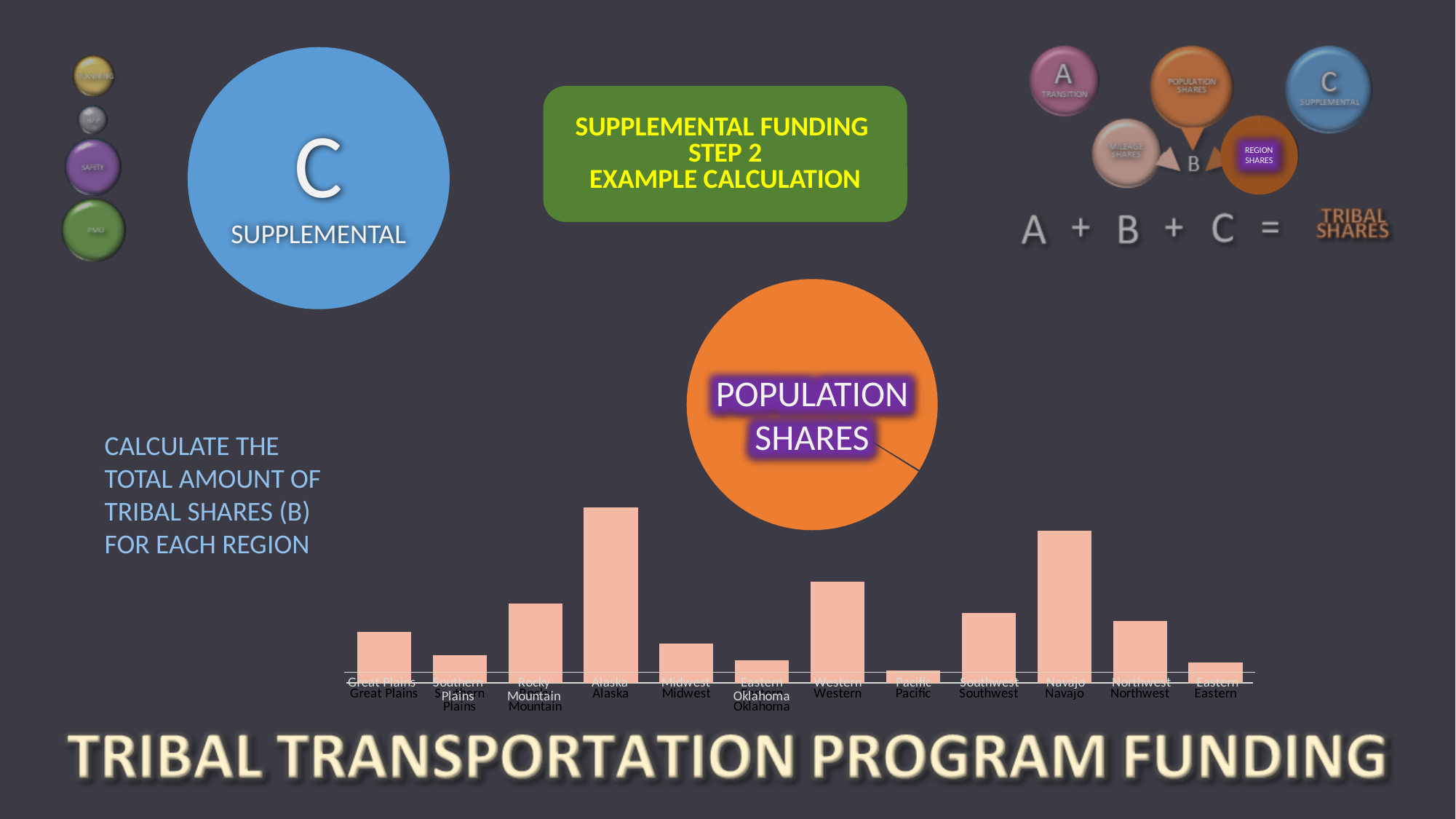
Which region has the second tallest bar in the chart? Navajo Which bar is taller, Great Plains or Southern Plains? Great Plains What label in the orange circle points to the bar chart? POPULATION SHARES Which bar is taller, Western or Rocky Mountain? Western How many regions are shown as categories in the bar chart? 12 Which bar is taller, Western or Southwest? Western What kind of chart is shown at the bottom of the slide? bar chart Which region has the shortest bar in the chart? Pacific Which region has the tallest bar in the chart? Alaska